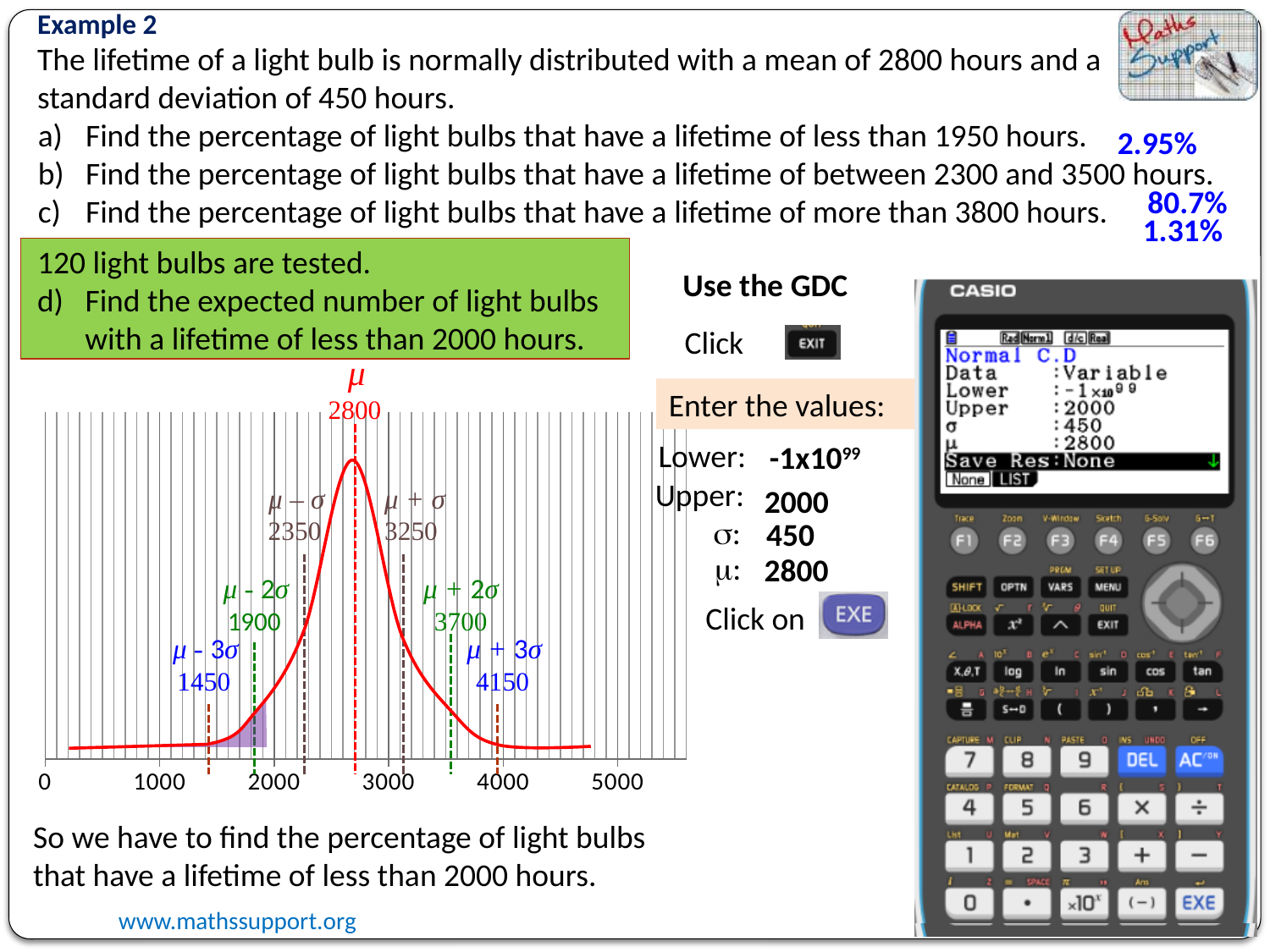
On the normal distribution chart, what value is labelled at μ − σ? 2350 On the normal distribution chart, what value is labelled at μ + σ? 3250 What kind of chart is the normal distribution graph on the slide? line chart On the normal distribution chart, what is the difference between the values labelled at μ + 3σ and μ? 1350 On the normal distribution chart, what value is labelled at μ + 3σ? 4150 On the normal distribution chart, what is the difference between the values labelled at μ + σ and μ − σ? 900 On the normal distribution chart, which is larger, the value labelled at μ + 2σ or at μ − 2σ? μ + 2σ On the normal distribution chart, what value is labelled at μ − 2σ? 1900 On the normal distribution chart, what value is labelled at μ − 3σ? 1450 On the normal distribution chart, what value is labelled at μ? 2800 How many tick labels are shown on the x axis of the normal distribution chart? 6 What colour is the curve drawn on the normal distribution chart? red